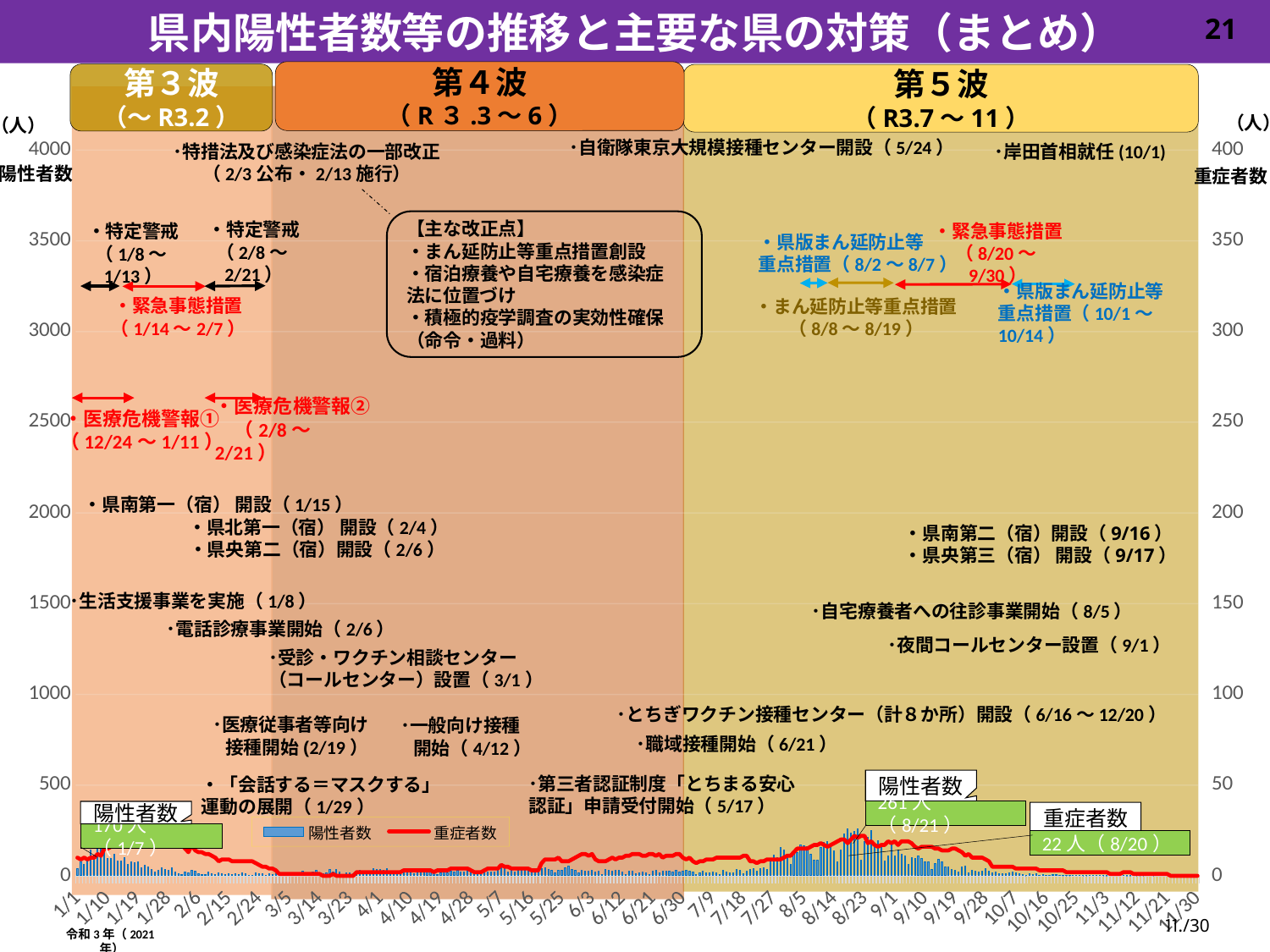
What are the two series named in the chart legend? 陽性者数 and 重症者数 What is the highest tick value shown on the left axis of the chart? 4000 In which wave (第3波, 第4波, 第5波) do the 陽性者数 bars reach their highest peak? 第5波 Which series is drawn as a red line, 陽性者数 or 重症者数? 重症者数 Do the 陽性者数 bars rise or fall from 7/9 to 8/23? rise Is the peak value of the 重症者数 line greater or less than 50 on the right axis? less Is the highest 陽性者数 bar greater or less than 500 on the left axis? less What kind of chart is shown on the slide? A combined bar and line chart Do the 陽性者数 bars rise or fall from late August (8/23) toward 11/30? fall According to the callout, what was the 重症者数 value on 8/20? 22人 What is the title of the slide containing the chart? 県内陽性者数等の推移と主要な県の対策（まとめ） How many series does the chart legend list? 2